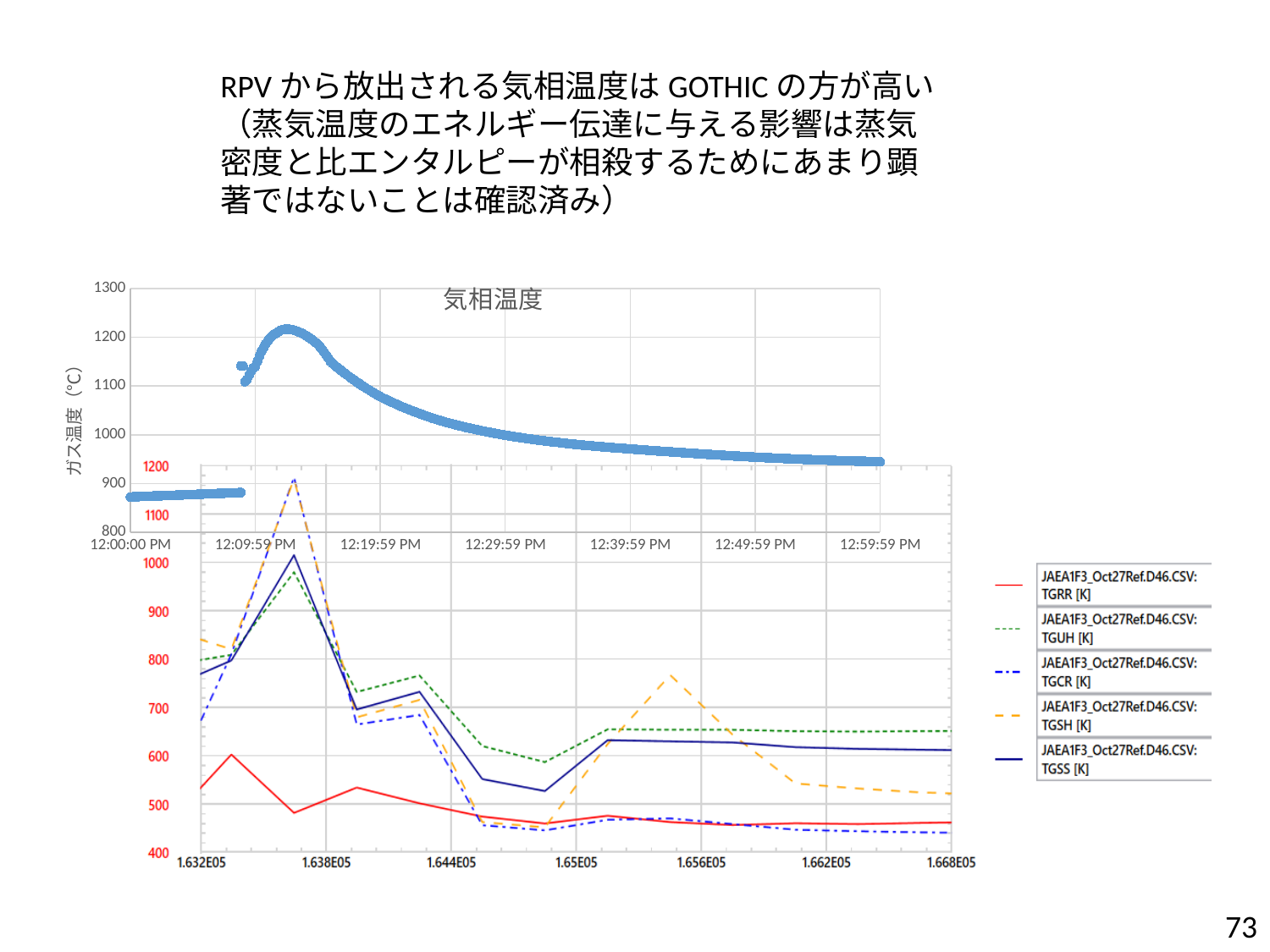
What is the title of the top chart? 気相温度 In the bottom chart, is the peak value of TGSH [K] near 1.637E05 greater or less than 1100? greater In the top chart titled 気相温度, do the values rise or fall between 12:19:59 PM and 12:59:59 PM? fall What kind of chart is the bottom chart? line chart In the bottom chart, is the value of TGUH [K] at 1.668E05 greater or less than 600? greater In the top chart titled 気相温度, is the value at 12:59:59 PM greater or less than 1000? less In the bottom chart, at 1.668E05, which is larger: TGUH [K] or TGSH [K]? TGUH [K] How many series does the legend of the bottom chart list? 5 In the top chart titled 気相温度, what is the y-axis label? ガス温度 (°C) What kind of chart is the top chart titled 気相温度? scatter chart